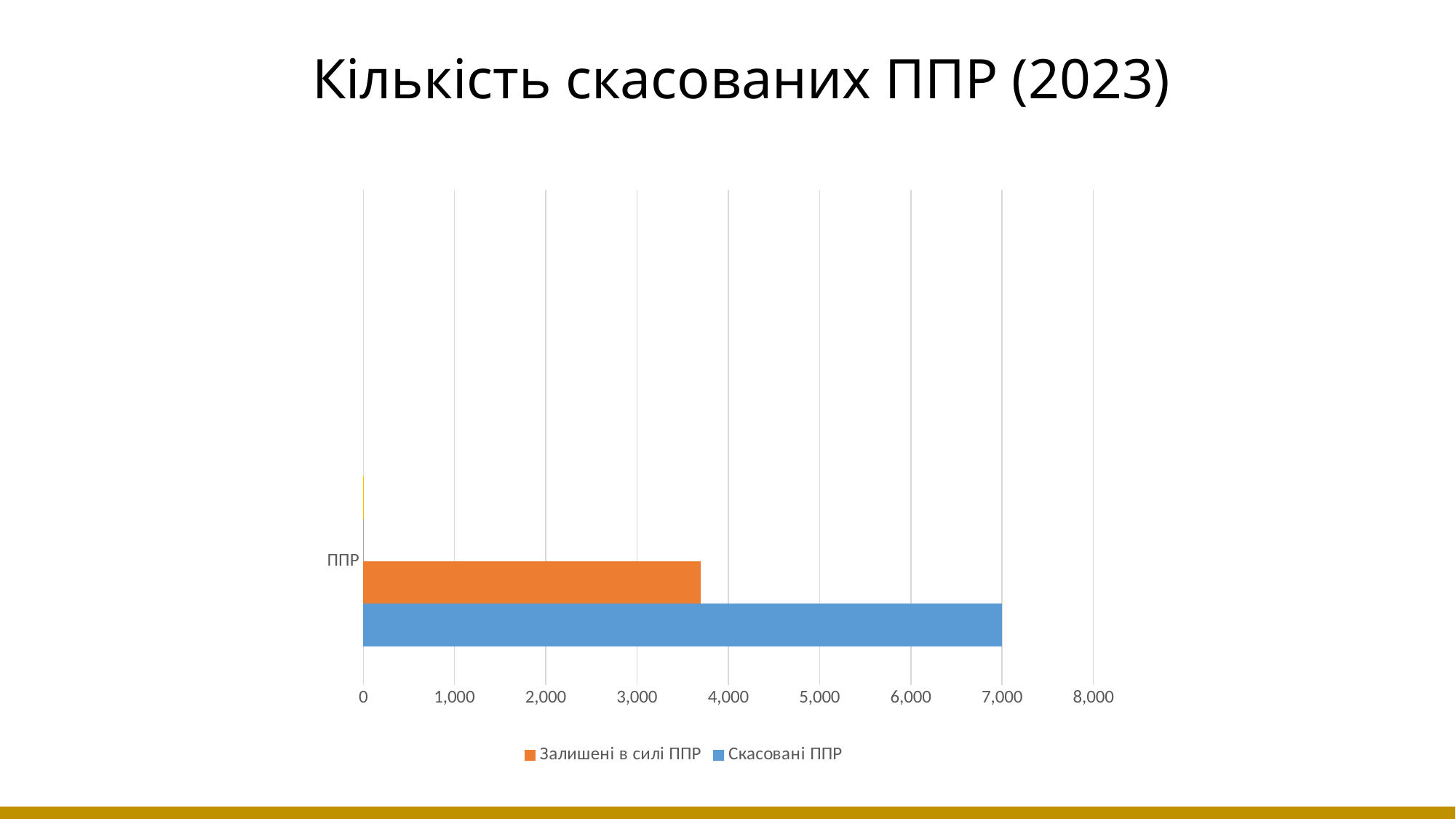
Which series has the larger value: Залишені в силі ППР or Скасовані ППР? Скасовані ППР What is the value for Скасовані ППР? 7,000 What kind of chart is shown on the slide? bar chart Is the value for Скасовані ППР greater or less than 6,000? greater What colour is the bar for Скасовані ППР? blue Which series has the lowest value? Залишені в силі ППР How many series does the legend list? 2 What is the title of the chart? Кількість скасованих ППР (2023) Is the value for Залишені в силі ППР greater or less than 4,000? less Which series has the highest value? Скасовані ППР How many categories are plotted on the vertical axis? 1 Is the value for Залишені в силі ППР greater or less than 3,000? greater